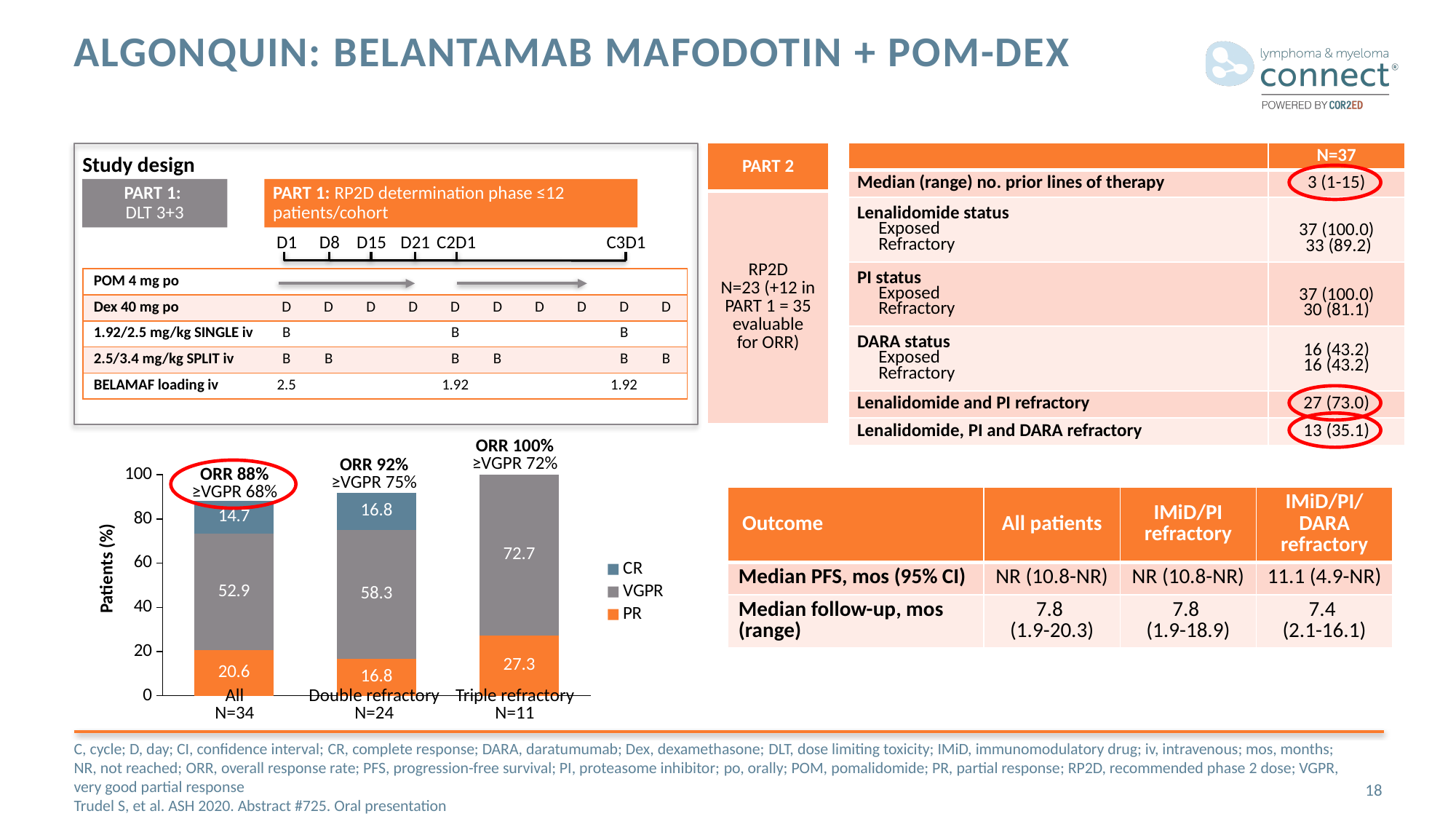
What is the VGPR value for the All (N=34) group? 52.9 How many series does the chart legend list? 3 Which group has the lowest PR value? Double refractory How many categories are shown on the x axis of the bar chart? 3 What kind of chart is shown on the slide? stacked bar chart What is the CR value for the Double refractory (N=24) group? 16.8 What is the total of the stacked bar for the Triple refractory group? 100 What is the difference between the VGPR values for the Triple refractory and All groups? 19.8 What is the PR value for the Triple refractory (N=11) group? 27.3 What is the y-axis label of the bar chart? Patients (%) Is the PR value larger for the All group or the Double refractory group? All Which group has the highest VGPR value? Triple refractory